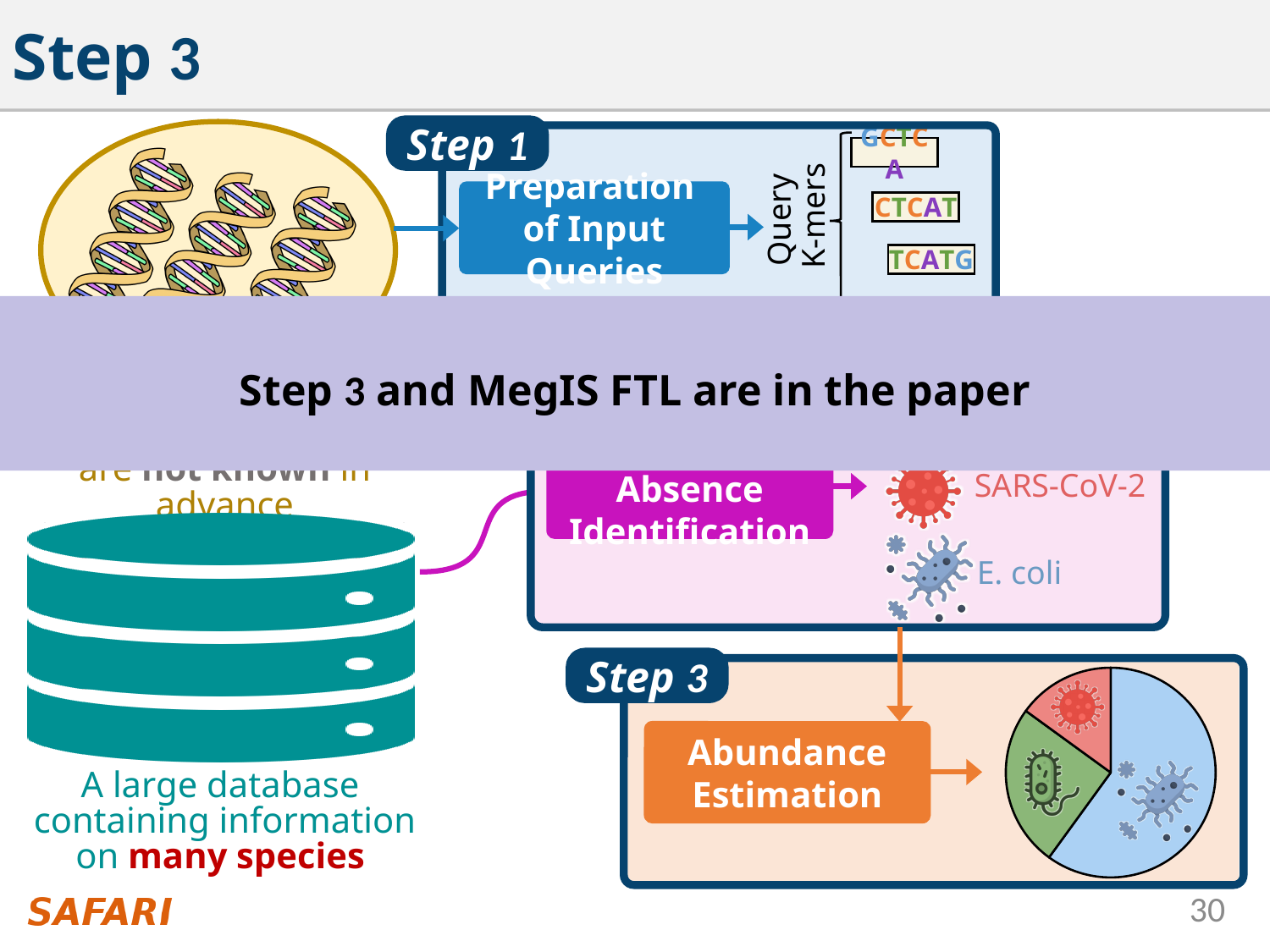
Does the blue slice of the pie chart in the Step 3 box take up more or less than half of the pie? more Which slice of the pie chart in the Step 3 box is the largest? the blue slice What colours are the three slices of the pie chart in the Step 3 box? red, green and blue In the pie chart in the Step 3 box, is the blue slice or the green slice larger? the blue slice How many slices does the pie chart in the Step 3 box have? 3 What kind of chart is shown in the Step 3 box next to "Abundance Estimation"? pie chart Which labelled box points to the pie chart in the Step 3 box? Abundance Estimation In the pie chart in the Step 3 box, is the blue slice or the red slice larger? the blue slice